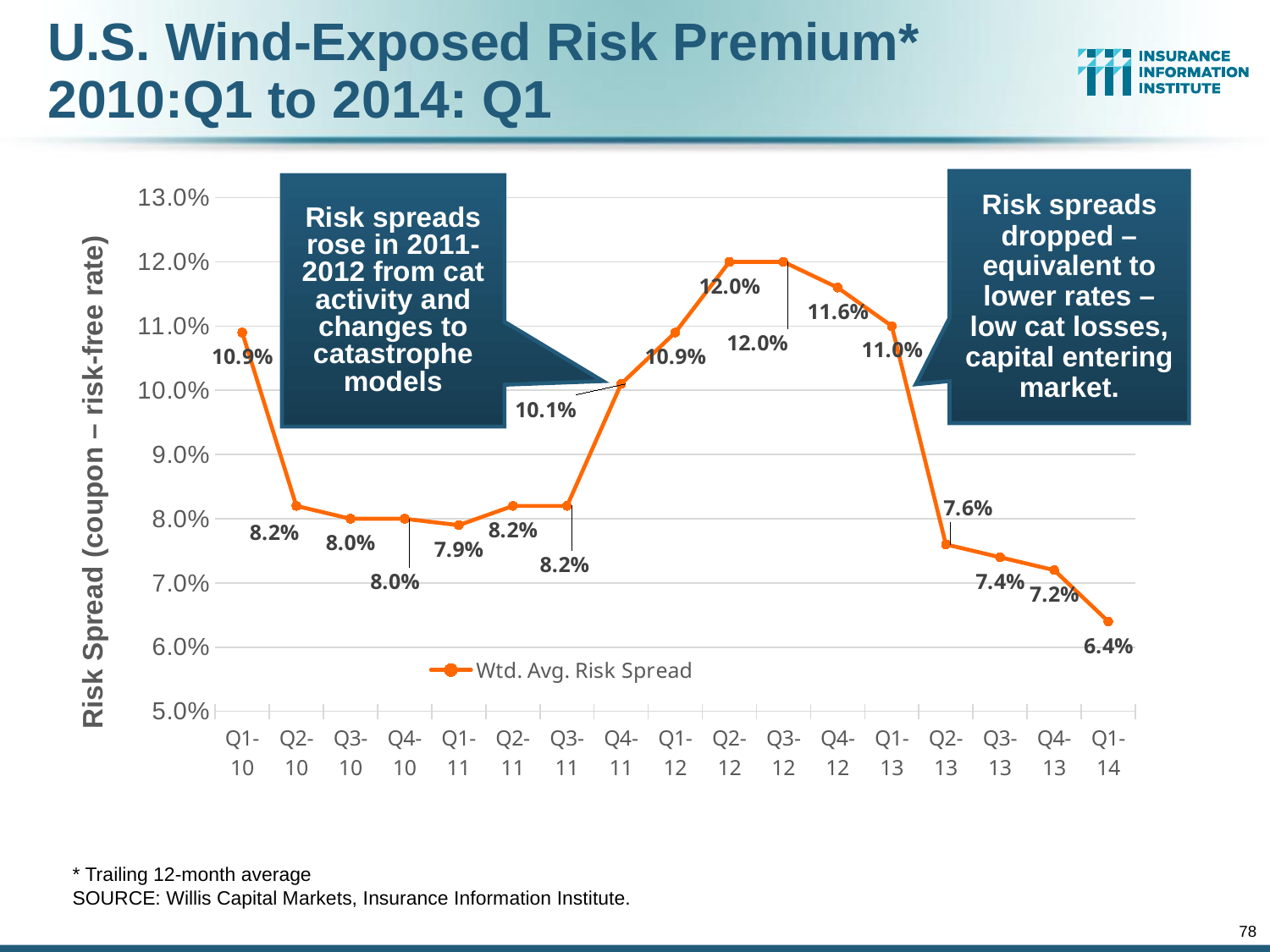
What kind of chart is shown on the slide? Line chart What is the weighted average risk spread for Q4-11? 10.1% What is the weighted average risk spread for Q1-10? 10.9% Which quarter has the lowest weighted average risk spread? Q1-14 What is the highest weighted average risk spread value shown on the chart? 12.0% Does the risk spread rise or fall from Q1-13 to Q1-14? Fall How many quarters are plotted on the chart? 17 How many series does the legend list? 1 What is the weighted average risk spread for Q1-14? 6.4% What is the difference between the risk spread in Q1-13 and Q2-13? 3.4 percentage points What is the name of the series shown in the legend? Wtd. Avg. Risk Spread Which quarter has a higher risk spread, Q4-12 or Q1-13? Q4-12